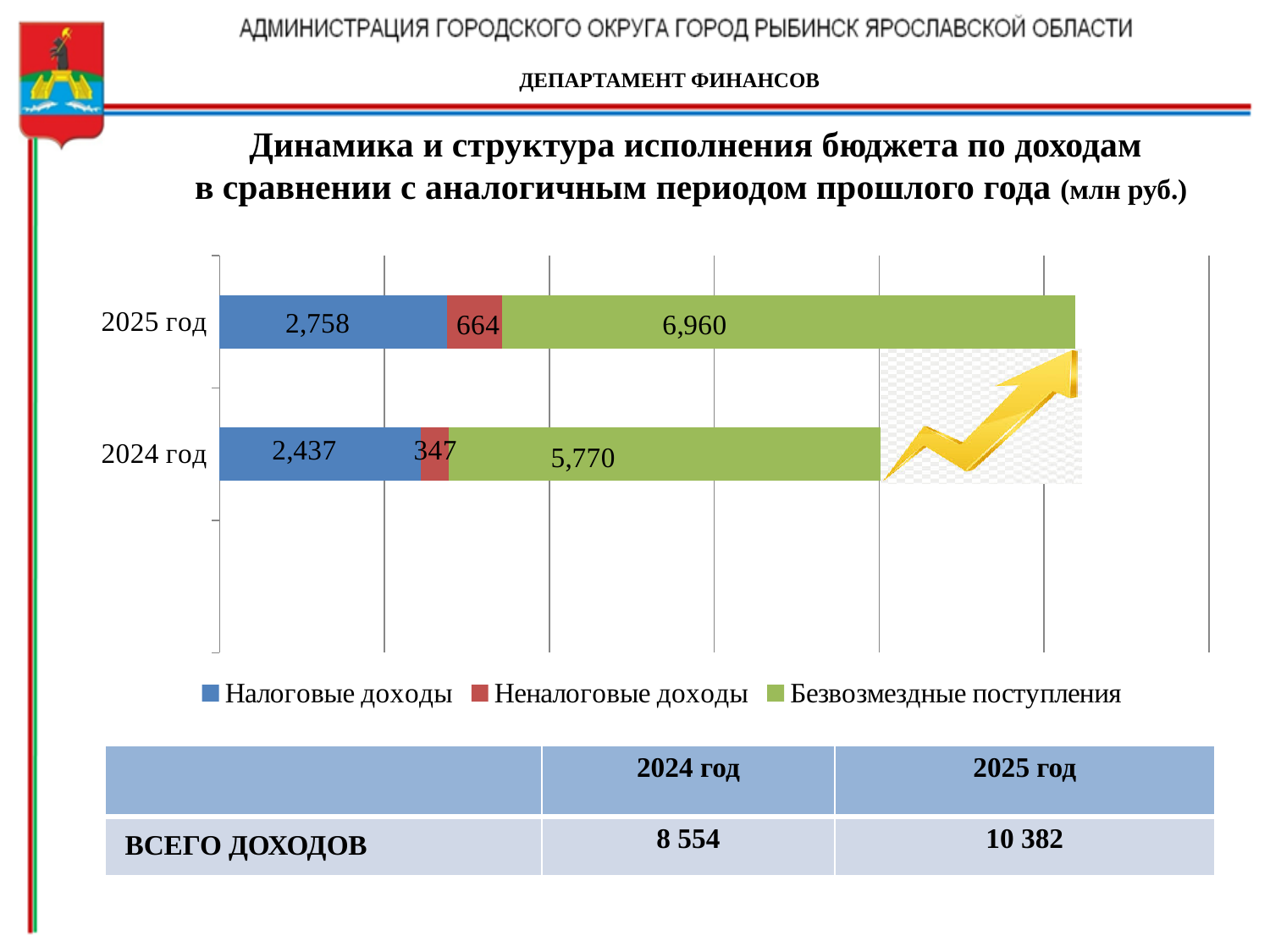
What is the total of the stacked bar for 2025 год? 10,382 Which series has the largest value in the 2025 год bar? Безвозмездные поступления What is the value of Неналоговые доходы for 2024 год? 347 What is the value of Неналоговые доходы for 2025 год? 664 What is the value of Налоговые доходы for 2025 год? 2,758 Which year has the larger value for Налоговые доходы, 2024 год or 2025 год? 2025 год How many categories (years) are shown in the chart? 2 What kind of chart is shown on the slide? Stacked bar chart What is the value of Безвозмездные поступления for 2024 год? 5,770 How many series does the legend list? 3 Which series has the smallest value in the 2024 год bar? Неналоговые доходы What is the difference between Безвозмездные поступления in 2025 год and 2024 год? 1,190